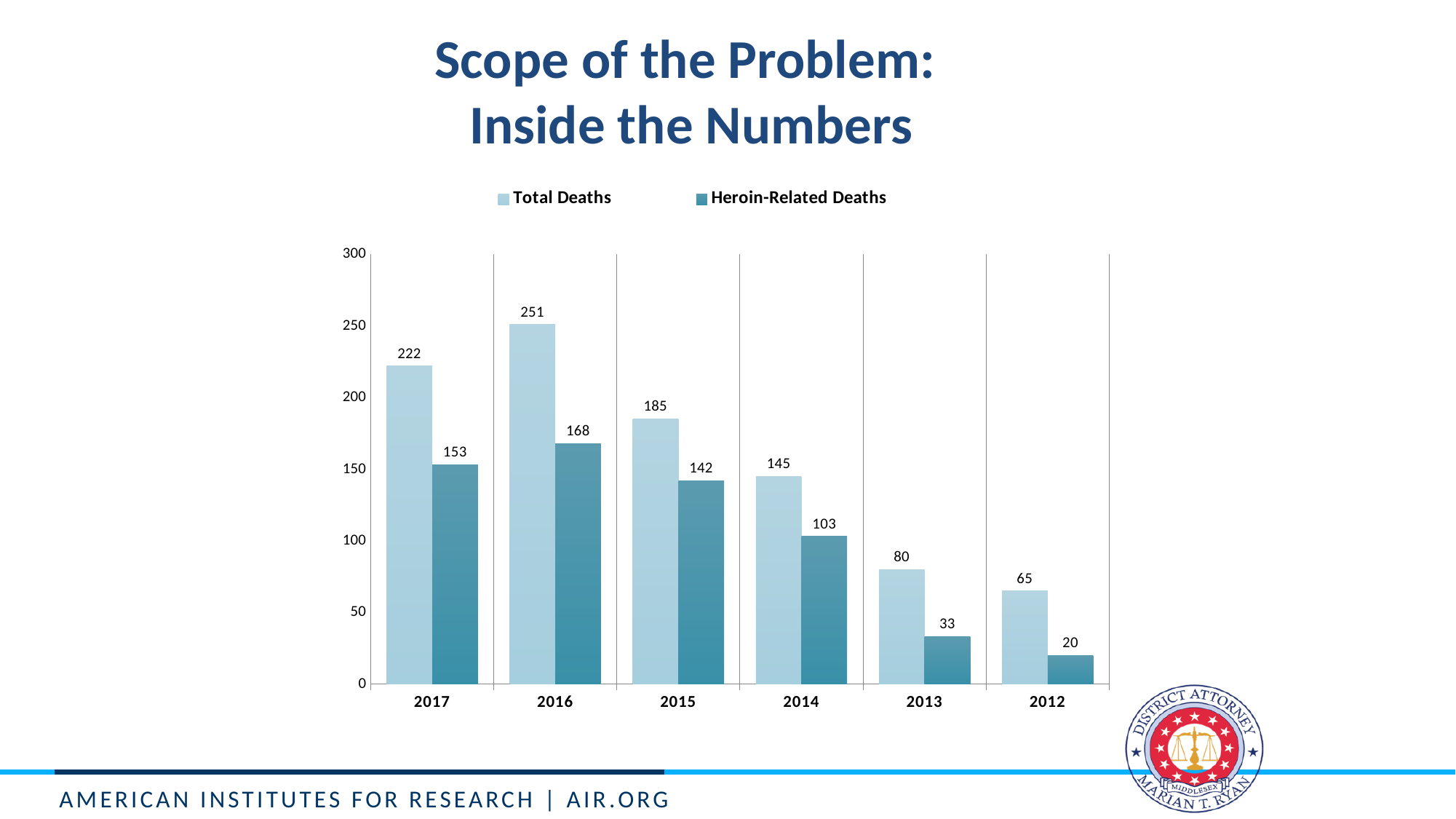
How many years are shown on the x axis? 6 Which year has the highest Total Deaths? 2016 Is the value of Total Deaths for 2015 greater or less than 200? less What kind of chart is shown on the slide? bar chart Which year has the lowest Heroin-Related Deaths? 2012 What is the value of Heroin-Related Deaths for 2014? 103 Do the Heroin-Related Deaths values rise or fall moving from 2017 to 2012 along the x axis? They rise from 2017 to 2016, then fall What is the title of the slide? Scope of the Problem: Inside the Numbers What is the difference between Total Deaths and Heroin-Related Deaths in 2017? 69 What is the value of Total Deaths for 2016? 251 Which is larger: Heroin-Related Deaths in 2015 or Total Deaths in 2014? Total Deaths in 2014 How many series does the legend list? 2